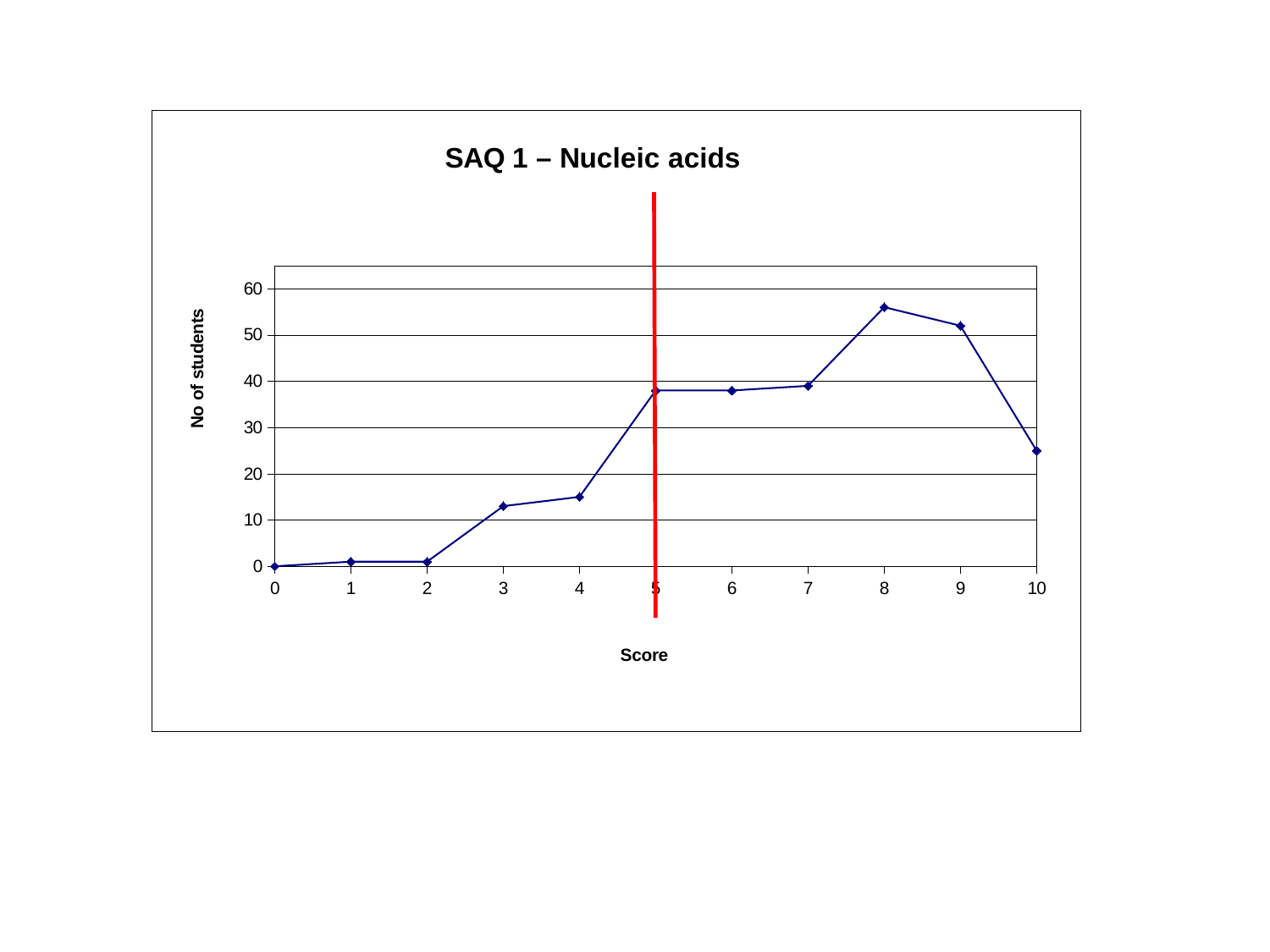
Which score has the lowest number of students? 0 Is the number of students for a score of 3 greater or less than 20? less What is the label of the vertical axis? No of students Is the number of students for a score of 10 greater or less than 30? less Which score has more students, 5 or 3? 5 What type of chart is shown on the slide? line chart Which score has the highest number of students? 8 What is the title of the chart? SAQ 1 – Nucleic acids Does the number of students rise or fall between a score of 9 and a score of 10? fall How many data points are plotted on the line? 11 Is the number of students for a score of 8 greater or less than 50? greater What is the number of students for a score of 0? 0